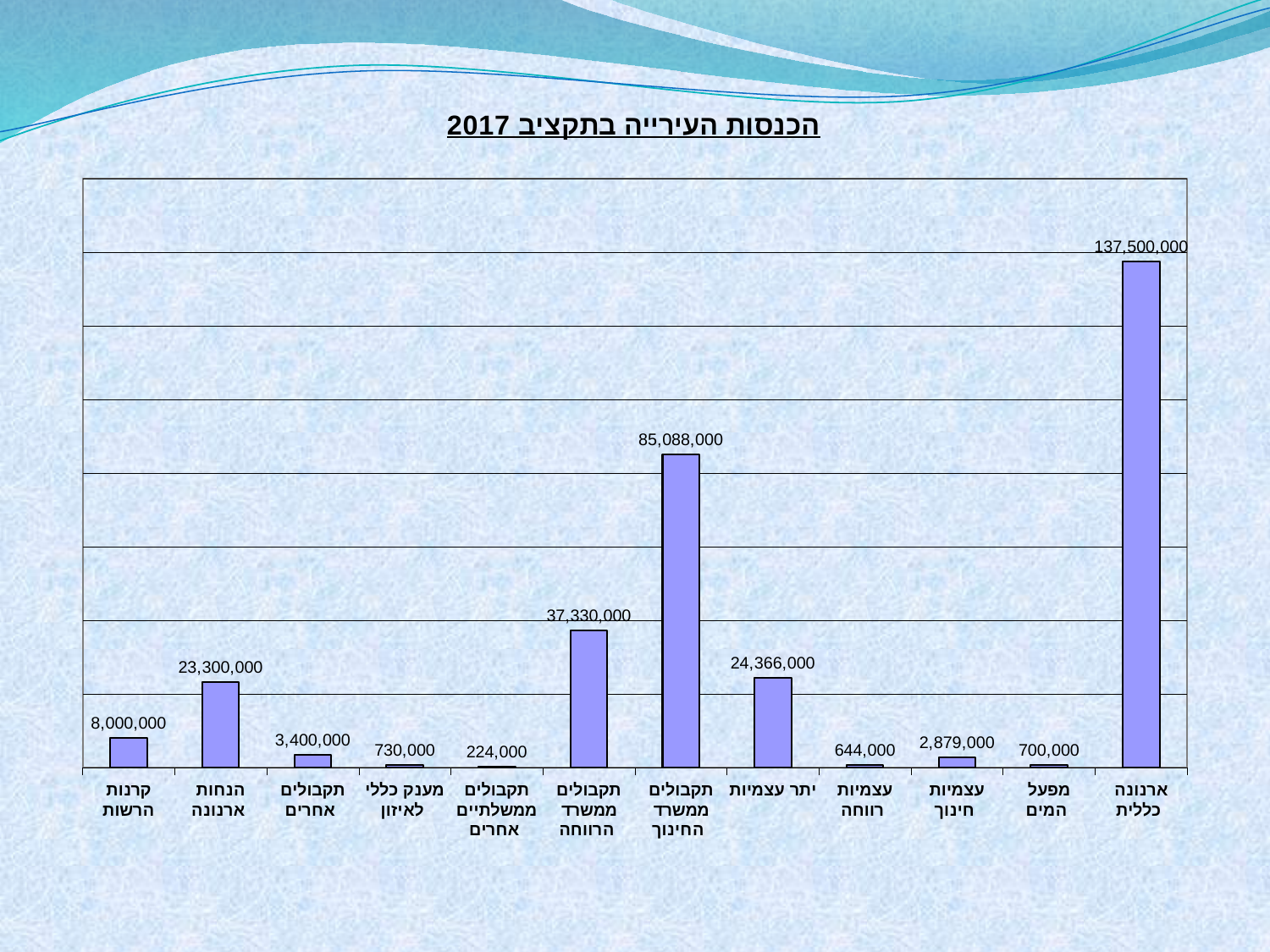
What is the difference between the values for יתר עצמיות and הנחות ארנונה? 1,066,000 How many categories are shown in the chart? 12 What is the title of the chart? הכנסות העירייה בתקציב 2017 What is the difference between the values for תקבולים ממשרד החינוך and תקבולים ממשרד הרווחה? 47,758,000 Which is larger, the value for עצמיות חינוך or the value for מפעל המים? עצמיות חינוך What kind of chart is shown on the slide? Bar chart What is the value for תקבולים ממשרד החינוך? 85,088,000 Which category has the highest value? ארנונה כללית What is the value for מענק כללי לאיזון? 730,000 What is the value for הנחות ארנונה? 23,300,000 Which category has the lowest value? תקבולים ממשלתיים אחרים What is the value for ארנונה כללית? 137,500,000